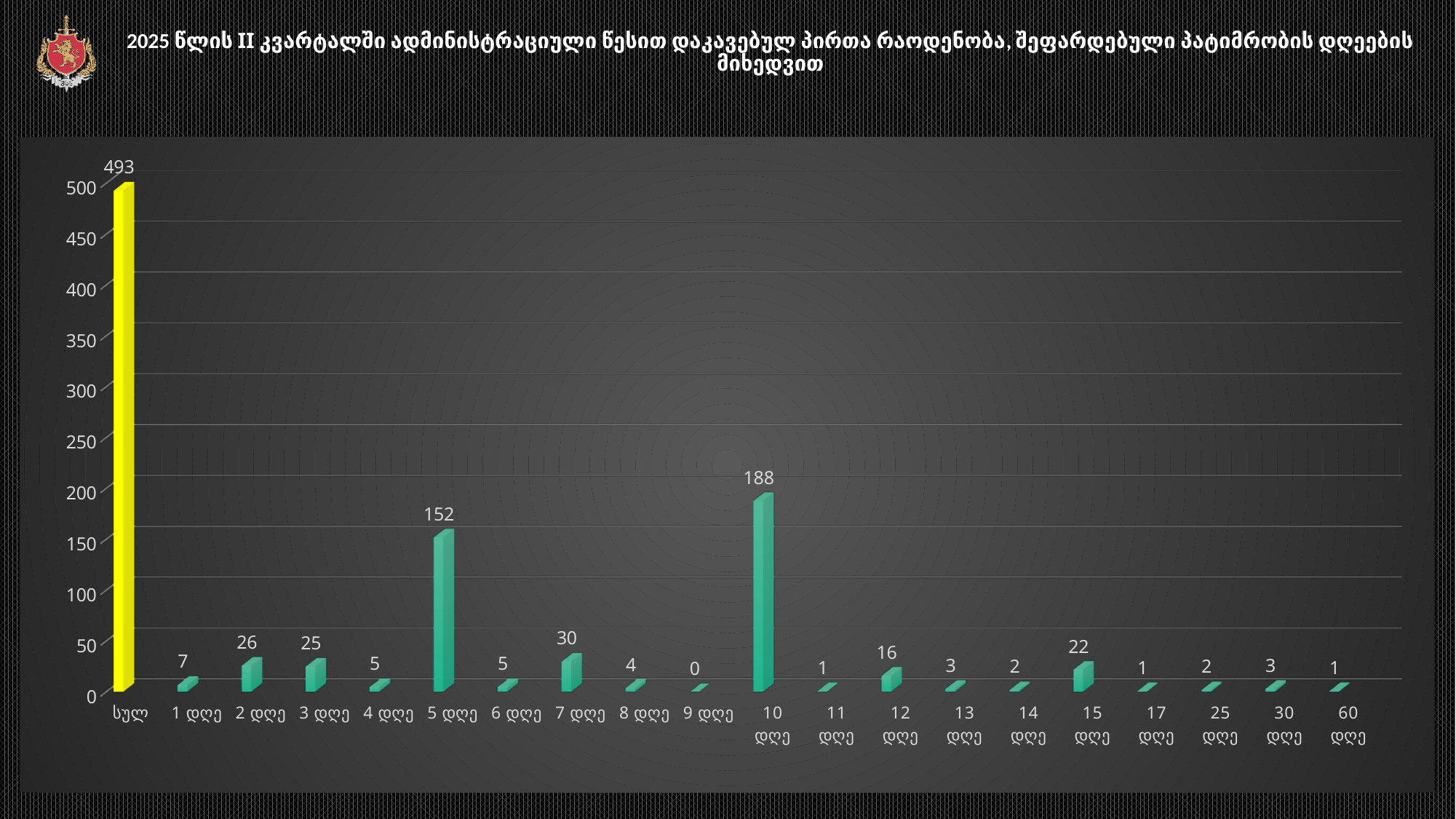
Which category has the lowest value? 9 დღე What kind of chart is shown on the slide? bar chart What is the value for "10 დღე"? 188 How many categories are shown on the x axis? 20 Is the value for "5 დღე" greater or less than 100? greater What is the value for the "სულ" bar? 493 Excluding the "სულ" total bar, which category has the highest value? 10 დღე Which is larger, the value for "2 დღე" or the value for "3 დღე"? 2 დღე What is the value for "15 დღე"? 22 What is the difference between the values for "10 დღე" and "5 დღე"? 36 What is the value for "5 დღე"? 152 What colour is the "სულ" bar? yellow